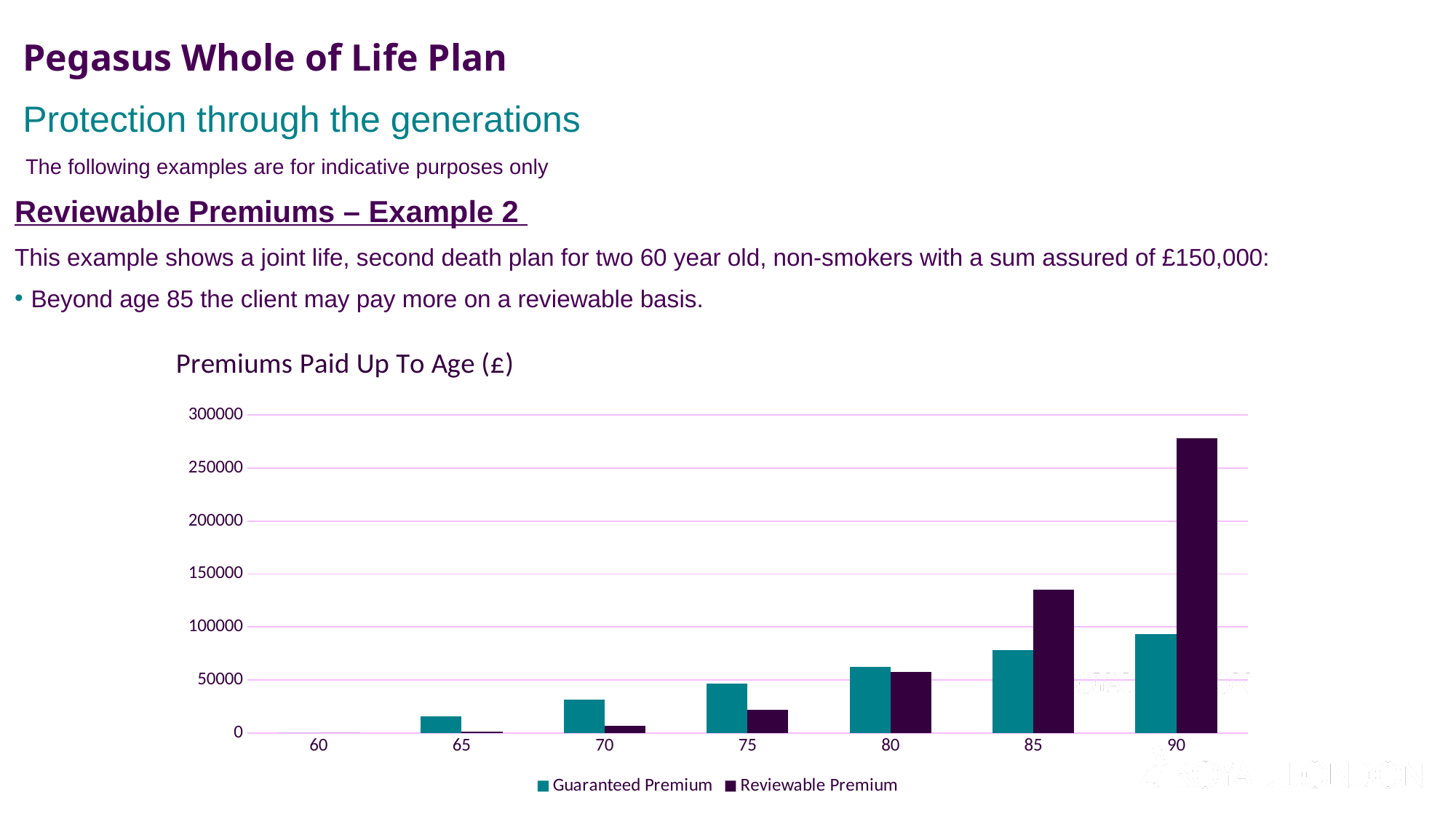
Do the Guaranteed Premium values rise or fall as age increases along the x axis? rise At age 75, which is larger: the Guaranteed Premium or the Reviewable Premium? Guaranteed Premium Is the Guaranteed Premium value at age 90 greater or less than 100000? less How many age categories are shown on the x axis of the chart? 7 Which series does the legend list first? Guaranteed Premium Is the Reviewable Premium value at age 90 greater or less than 250000? greater At age 90, which is larger: the Guaranteed Premium or the Reviewable Premium? Reviewable Premium Is the Reviewable Premium value at age 85 greater or less than 100000? greater At which age is the Reviewable Premium highest? 90 How many series does the legend of the chart list? 2 What type of chart is shown under the title 'Premiums Paid Up To Age (£)'? bar chart